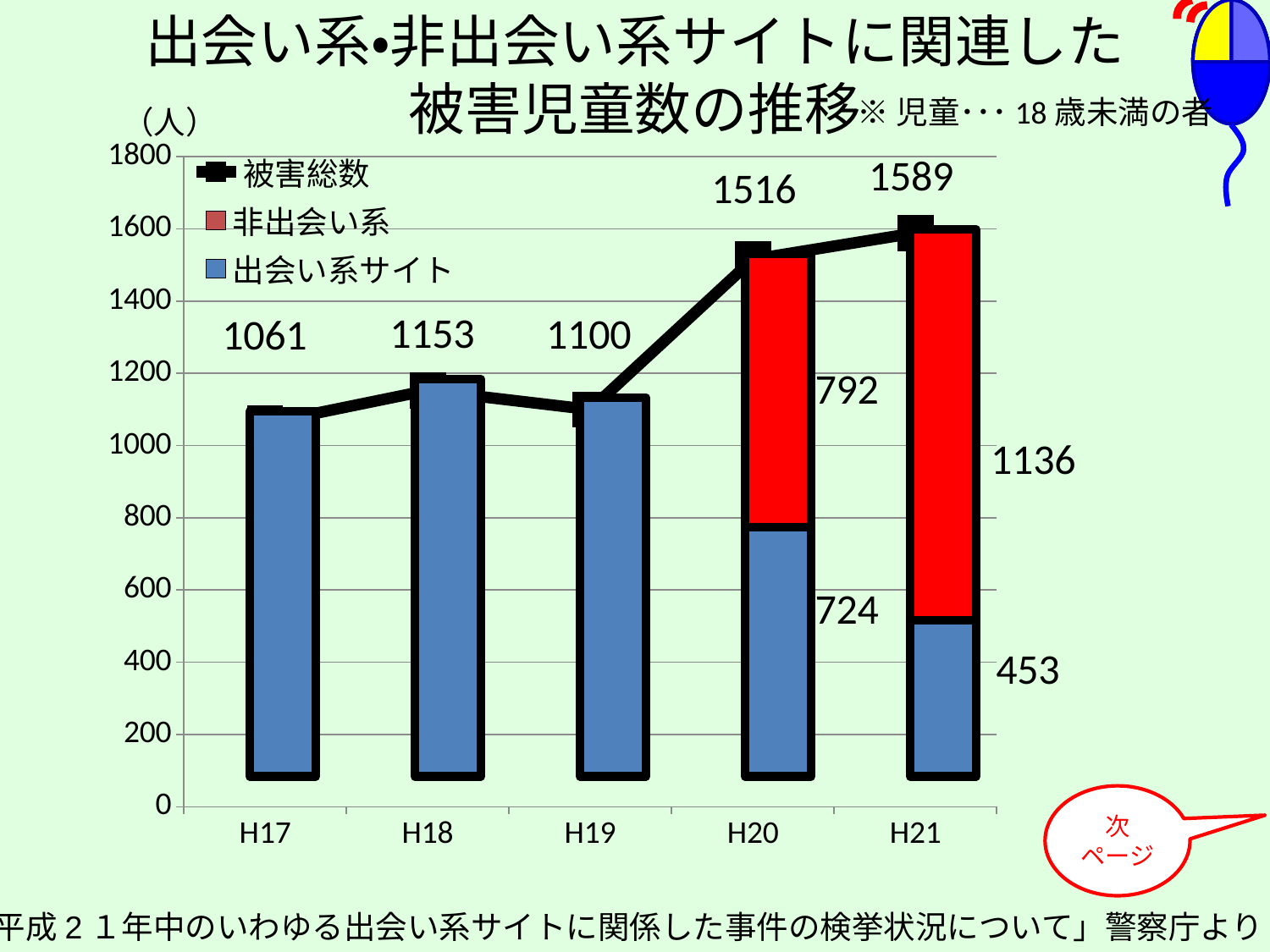
How many years are shown on the x axis? 5 What is the value of 被害総数 for H20? 1516 What is the value of 出会い系サイト for H20? 724 What is the total of the stacked bar for H21? 1589 What is the value of 非出会い系 for H21? 1136 Which year has the lowest 被害総数? H17 Which year has the highest 被害総数? H21 Which is larger, the 出会い系サイト value for H20 or for H21? H20 Is the 出会い系サイト value for H17 greater or less than 1000? greater How many series does the legend list? 3 What is the value of 被害総数 for H17? 1061 What is the difference between the 被害総数 for H21 and H20? 73